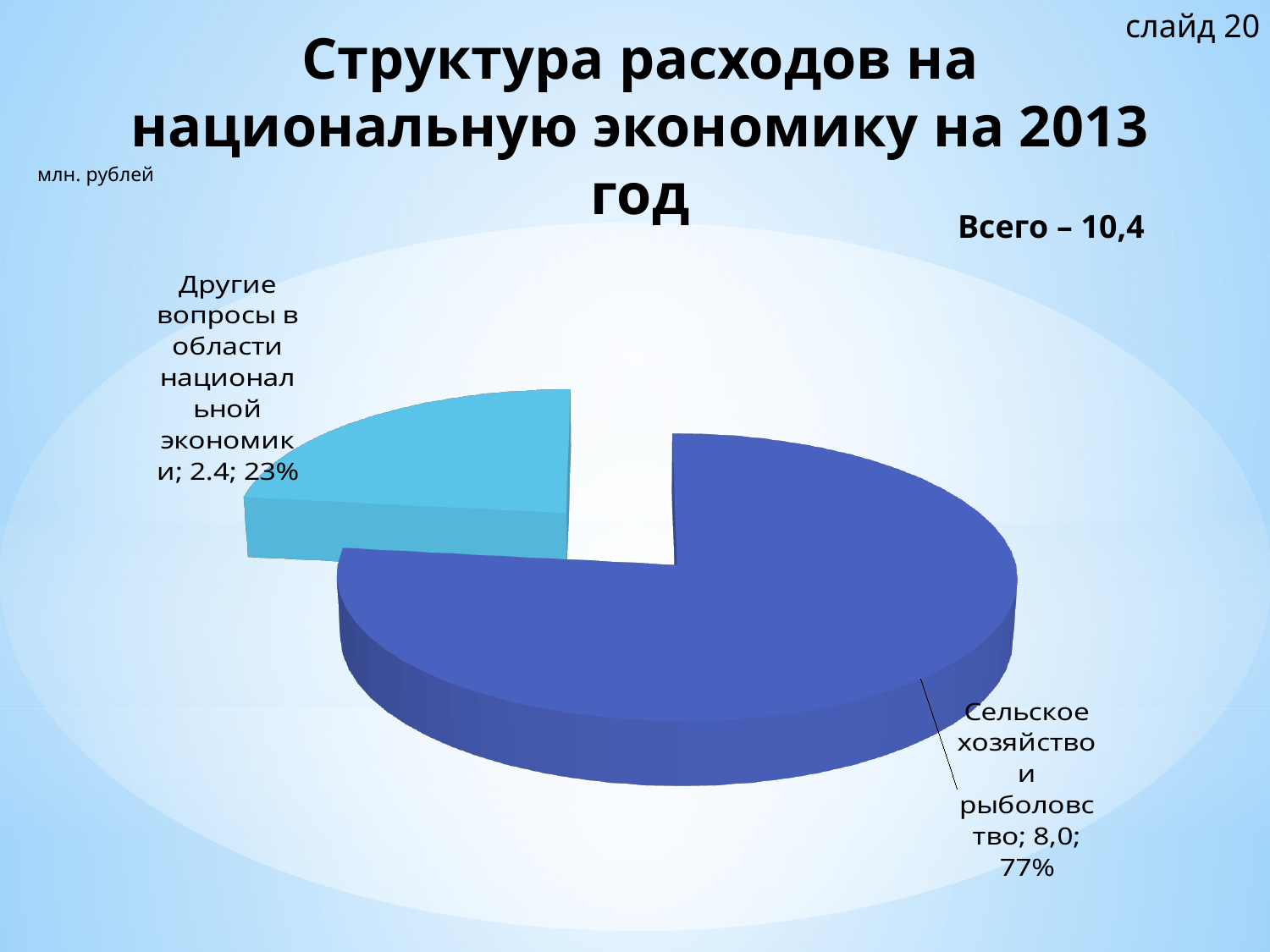
What is the value for Сельское хозяйство и рыболовство? 8,0 Which category has the largest slice of the pie? Сельское хозяйство и рыболовство Which is larger: Сельское хозяйство и рыболовство or Другие вопросы в области национальной экономики? Сельское хозяйство и рыболовство What share of the pie does Другие вопросы в области национальной экономики take? 23% What share of the pie does Сельское хозяйство и рыболовство take? 77% What total (Всего) is stated on the slide for the chart? 10,4 What kind of chart is shown on the slide? pie chart What is the value for Другие вопросы в области национальной экономики? 2.4 What is the title of the chart on the slide? Структура расходов на национальную экономику на 2013 год What unit of measurement is indicated for the chart values? млн. рублей How many slices does the pie chart have? 2 Which category has the smallest slice of the pie? Другие вопросы в области национальной экономики